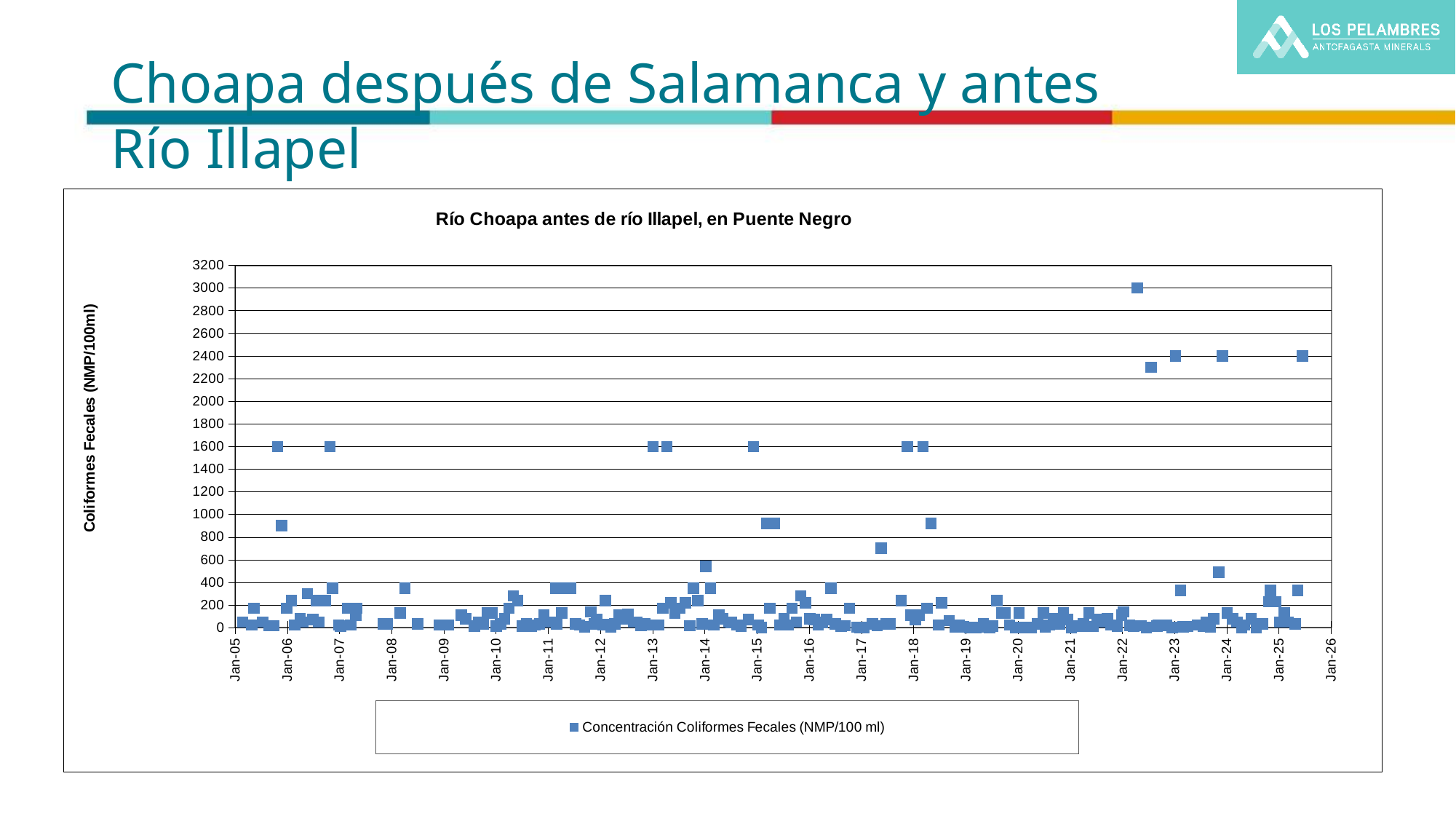
What is the title of the chart? Río Choapa antes de río Illapel, en Puente Negro Is the highest plotted value in 2008 greater or less than 600? less In which year does the highest plotted value occur? 2022 What is the label of the vertical axis? Coliformes Fecales (NMP/100ml) Is the highest plotted value in 2023 greater or less than 2000? greater What is the last date label on the horizontal axis? Jan-26 Is the highest plotted value greater or less than 2800? greater What is the maximum value shown on the vertical axis? 3200 What kind of chart is shown on the slide? scatter chart What is the first date label on the horizontal axis? Jan-05 How many series does the legend list? 1 How many date tick labels are shown on the horizontal axis? 22